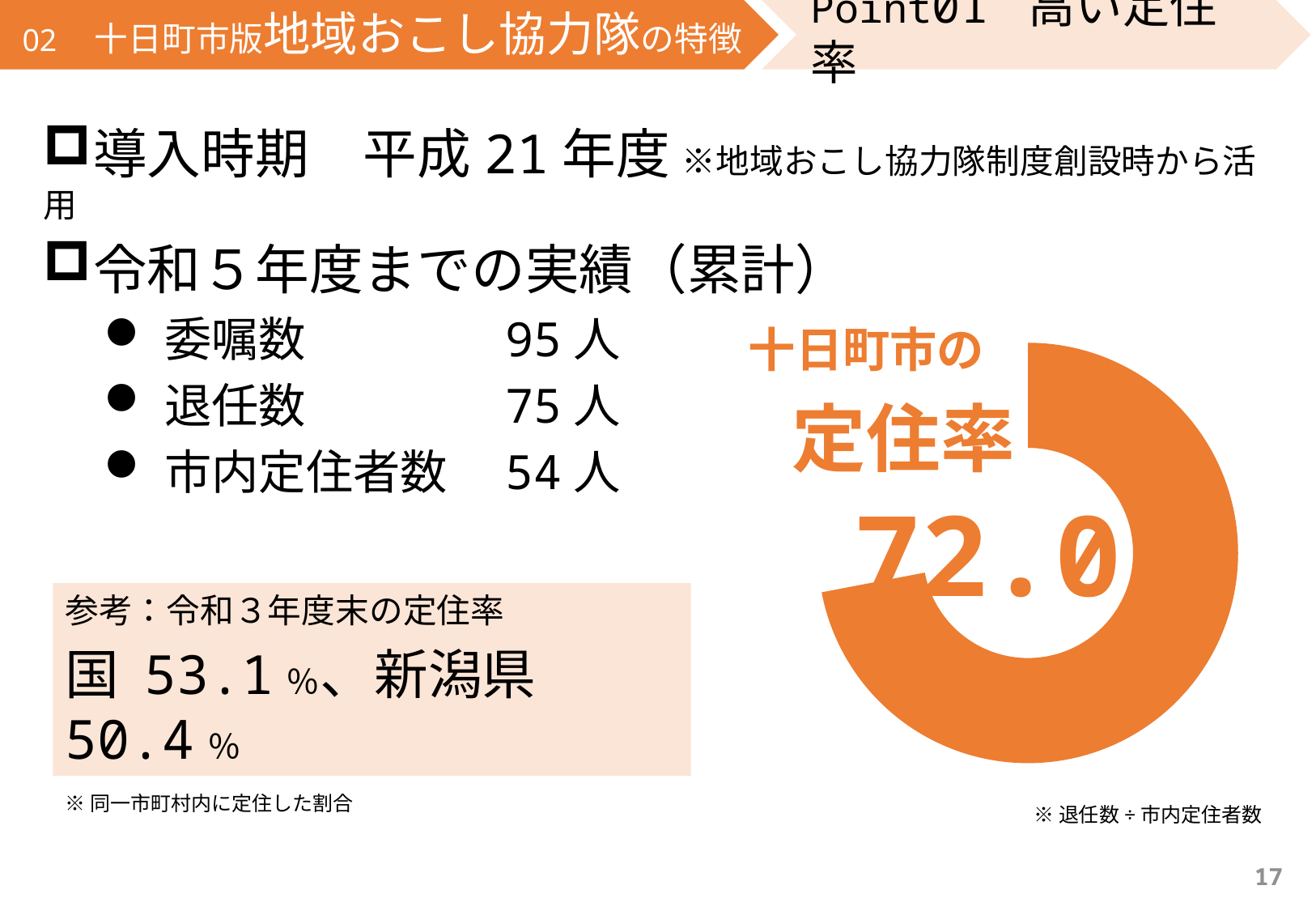
According to the note under the doughnut chart, how is the settlement rate calculated? 退任数÷市内定住者数 What is the title of the doughnut chart? 十日町市の定住率 What colour is the filled segment of the doughnut chart? orange Does the filled segment of the doughnut chart cover more or less than half of the ring? more Is the settlement rate shown in the doughnut chart (72.0) larger or smaller than the national rate of 53.1% shown on the slide? larger By how many percentage points does the doughnut chart value of 72.0 exceed the Niigata prefecture rate of 50.4%? 21.6 What kind of chart is shown on the right side of the slide? doughnut chart What value is displayed in the centre of the doughnut chart? 72.0